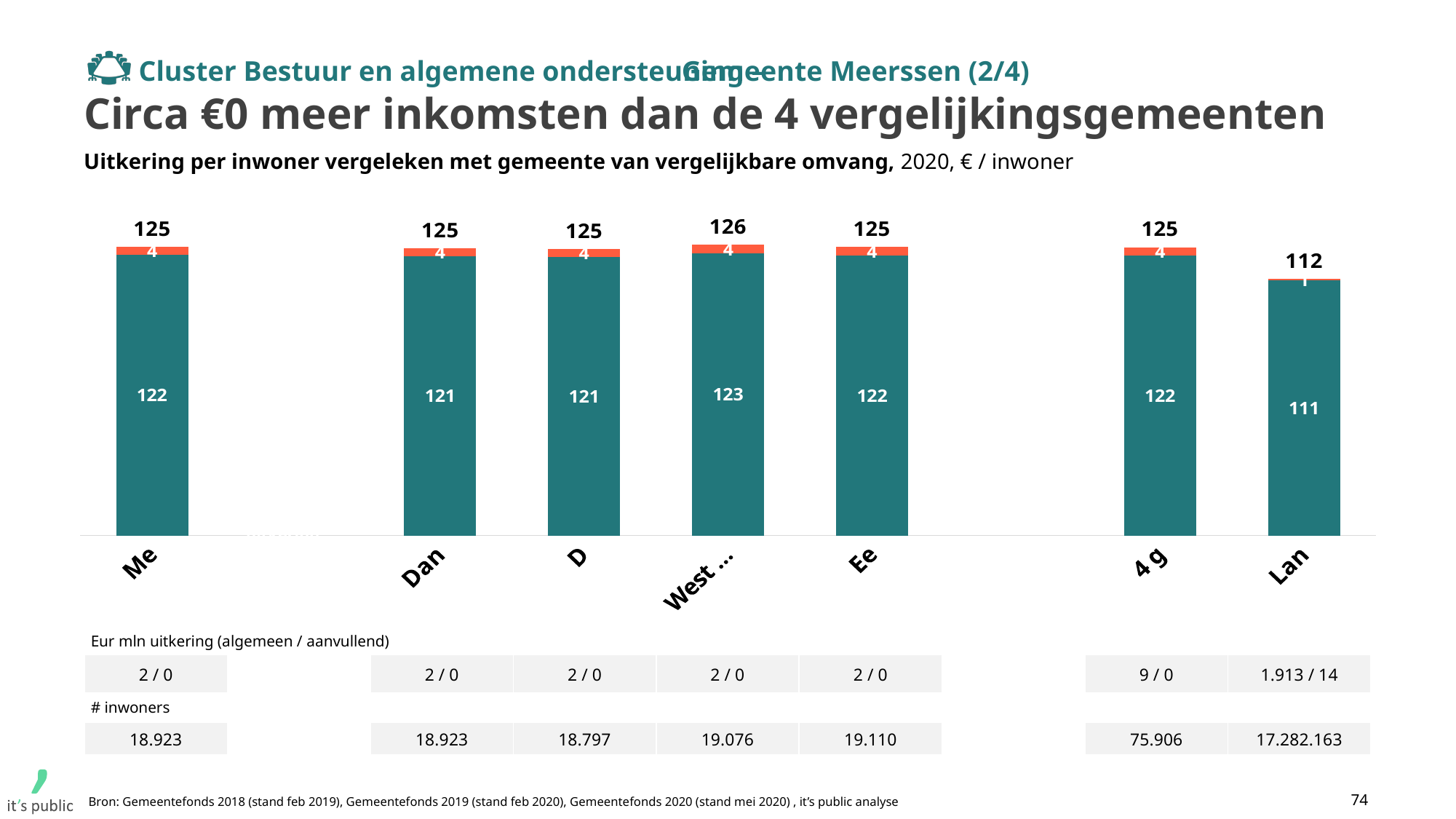
What is the difference between the total for Me and the total for Lan? 13 What is the total value shown above the bar for Lan? 112 Which category has the highest total value? West ... What is the total value shown above the bar for Me? 125 In what unit are the values in the chart expressed, according to the subtitle? € / inwoner What is the value of the orange (upper) segment for Me? 4 What is the value of the teal (lower) segment for Dan? 121 What is the value of the teal (lower) segment for West ...? 123 How many bars are shown in the chart? 7 Which category has the lowest total value? Lan What kind of chart is shown on the slide? Stacked bar chart Which has a larger total value, Me or Lan? Me